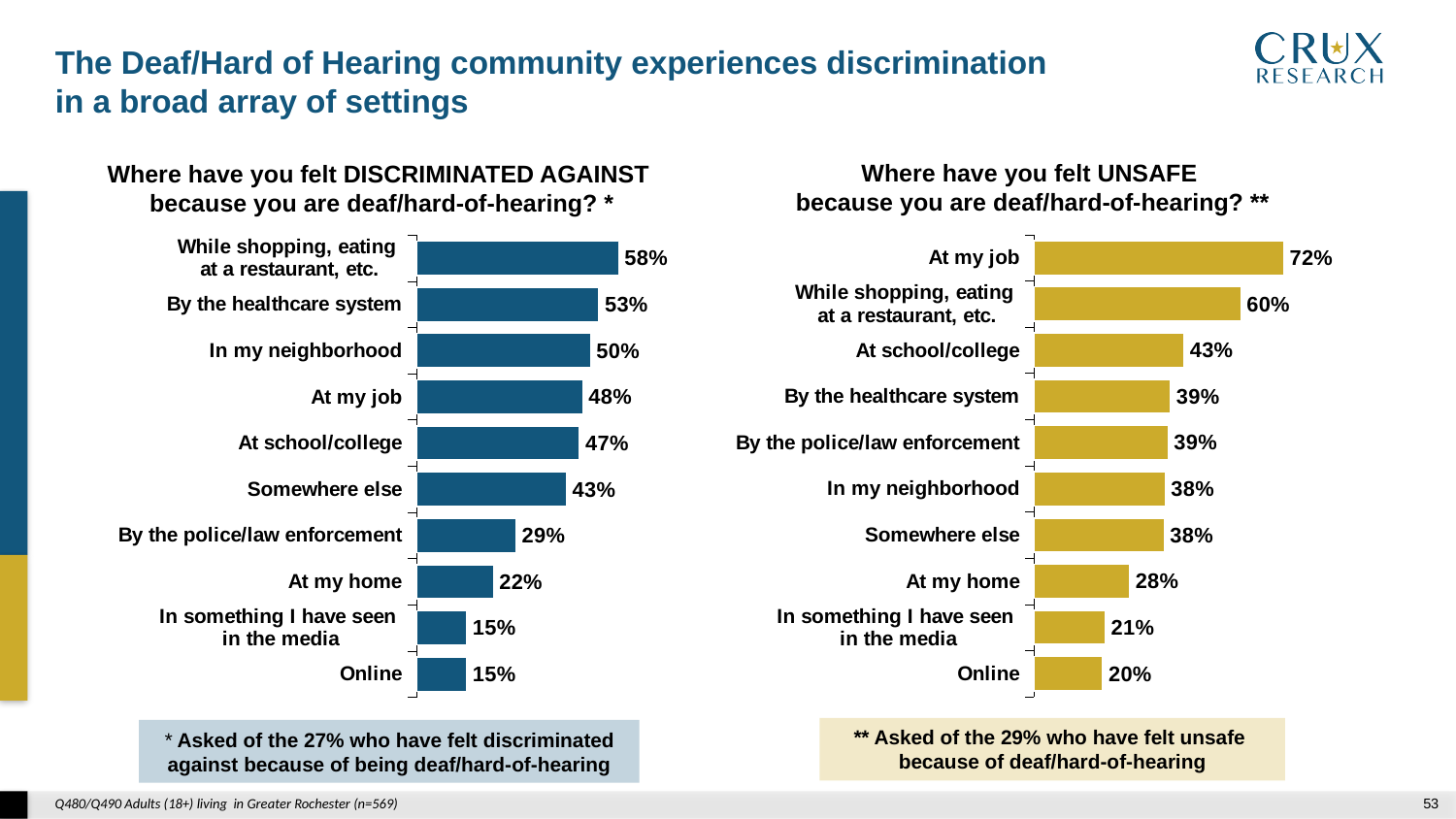
In the 'Where have you felt DISCRIMINATED AGAINST' chart, what is the value for 'By the healthcare system'? 53% How many categories are shown in the 'Where have you felt UNSAFE' chart? 10 What type of chart is the 'Where have you felt DISCRIMINATED AGAINST' chart? Bar chart In the 'Where have you felt DISCRIMINATED AGAINST' chart, what is the value for 'At my job'? 48% In the 'Where have you felt UNSAFE' chart, what is the value for 'At school/college'? 43% In the 'Where have you felt UNSAFE' chart, which category has the highest value? At my job In the 'Where have you felt DISCRIMINATED AGAINST' chart, what is the difference between 'In my neighborhood' and 'At my home'? 28% In the 'Where have you felt UNSAFE' chart, what is the difference between 'At my job' and 'While shopping, eating at a restaurant, etc.'? 12% In the 'Where have you felt DISCRIMINATED AGAINST' chart, which category has the highest value? While shopping, eating at a restaurant, etc. In the 'Where have you felt DISCRIMINATED AGAINST' chart, which is larger: 'Somewhere else' or 'By the police/law enforcement'? Somewhere else What colour are the bars in the 'Where have you felt UNSAFE' chart? Gold/yellow In the 'Where have you felt UNSAFE' chart, which category has the lowest value? Online